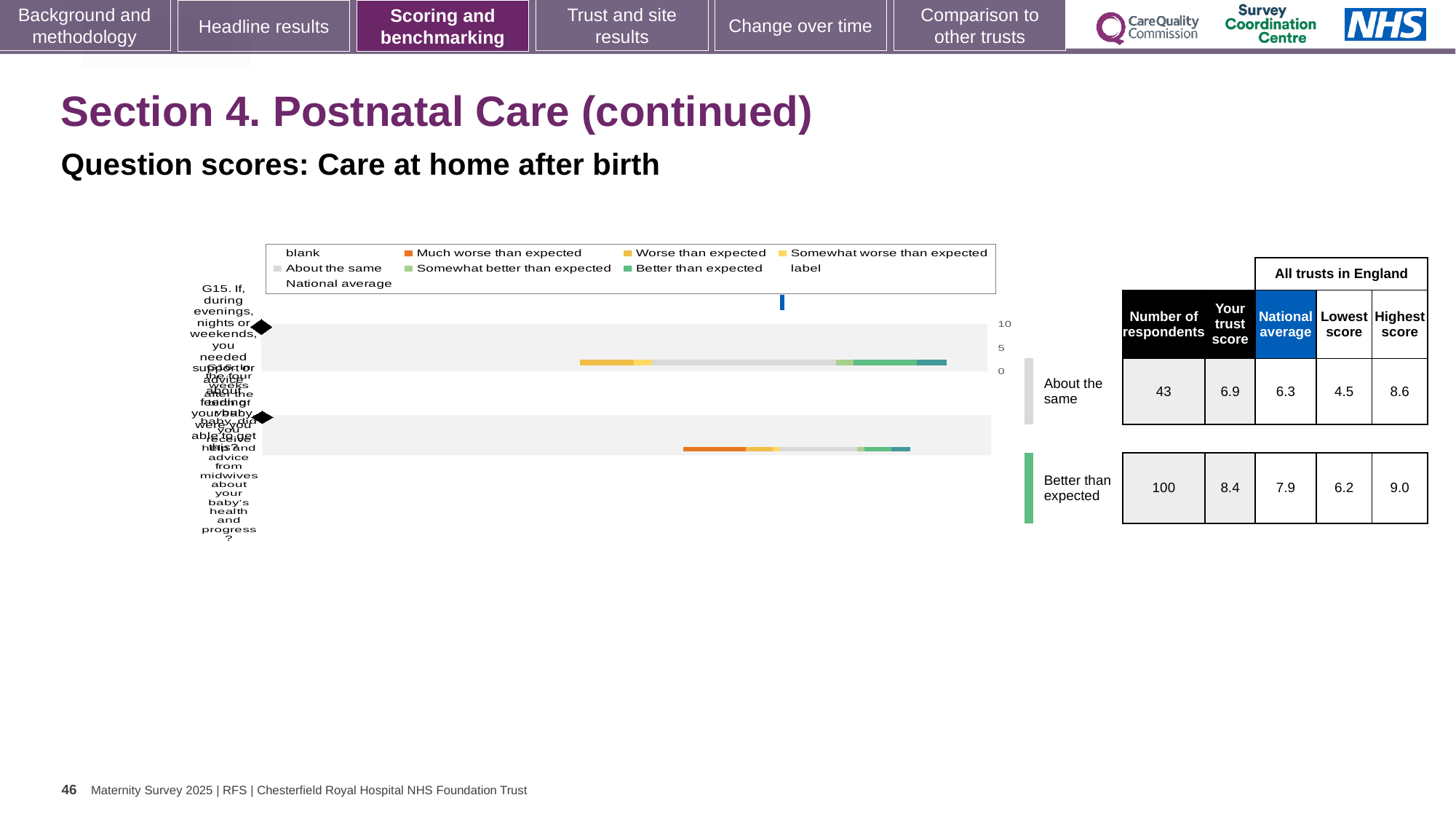
How many question rows are plotted in the chart? 2 In the table beside the chart, what is the lowest score for the row rated 'About the same'? 4.5 For the row rated 'Better than expected', how much higher is the trust score than the national average? 0.5 What is the subtitle above the chart? Question scores: Care at home after birth For the row rated 'About the same', what is the difference between the highest score and the lowest score? 4.1 In the table beside the chart, what is the national average for the row rated 'About the same'? 6.3 What kind of chart is shown on the slide? bar chart What colour represents 'Much worse than expected' in the chart legend? orange In the table beside the chart, what is the number of respondents for the row rated 'About the same'? 43 In the table beside the chart, what is the trust score for the row rated 'Better than expected'? 8.4 In the table beside the chart, what is the highest score for the row rated 'Better than expected'? 9.0 Which row has the higher trust score, 'About the same' or 'Better than expected'? Better than expected